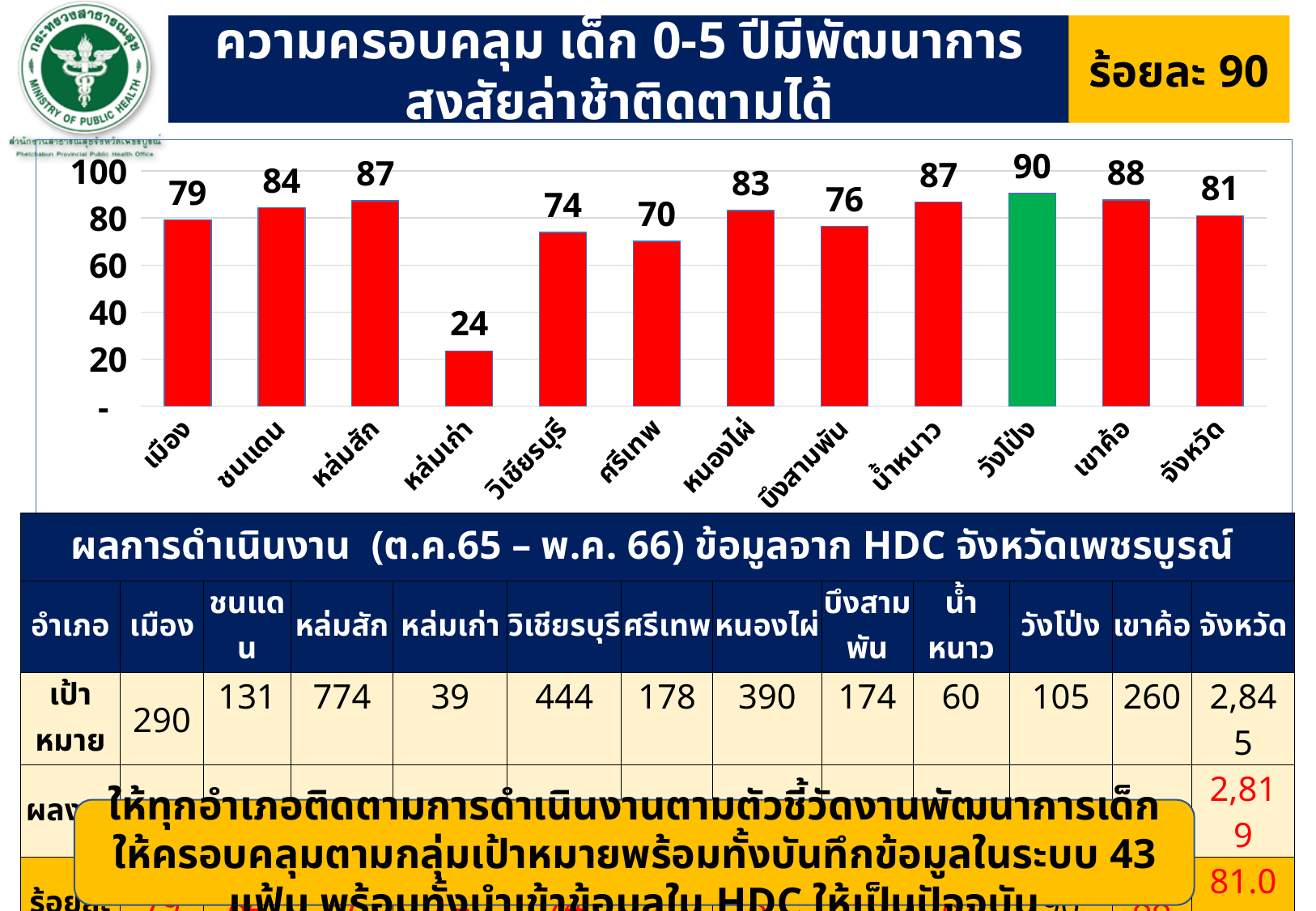
Which category has the highest value in the bar chart? วังโป่ง Which category has the lowest value in the bar chart? หล่มเก่า What is the difference between the values for เขาค้อ and เมือง in the bar chart? 9 What is the value for หล่มเก่า in the bar chart? 24 What is the value for บึงสามพัน in the bar chart? 76 What is the value for จังหวัด in the bar chart? 81 Which is larger in the bar chart, the value for ชนแดน or the value for ศรีเทพ? ชนแดน What is the value for วังโป่ง in the bar chart? 90 Which bar in the chart is coloured green rather than red? วังโป่ง Is the value for หนองไผ่ in the bar chart greater or less than 60? greater What kind of chart is shown on the slide? bar chart How many categories are shown on the x axis of the bar chart? 12